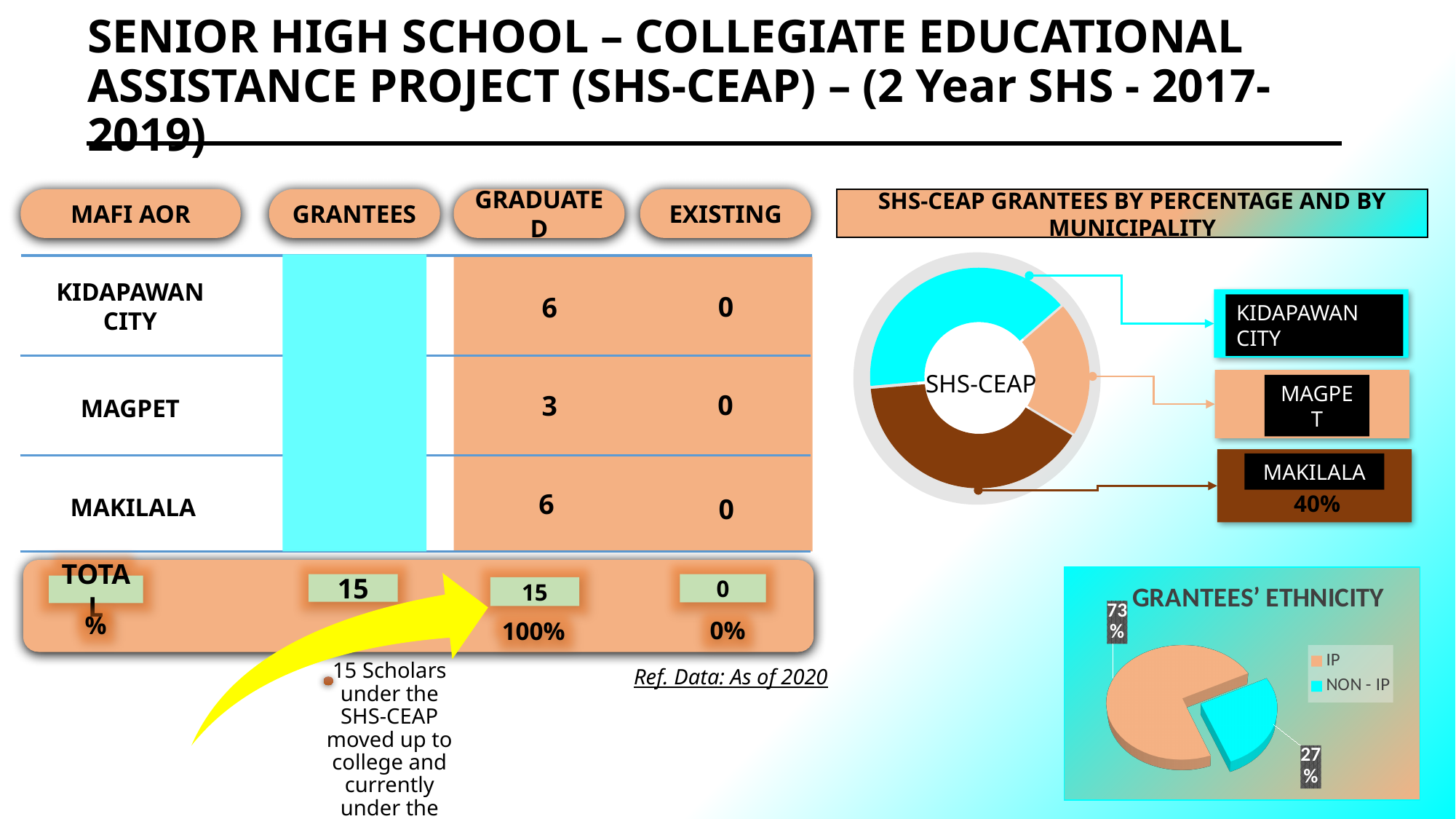
What kind of chart is the GRANTEES' ETHNICITY chart? Pie chart In the GRANTEES' ETHNICITY chart, which category has the larger share? IP In the SHS-CEAP GRANTEES BY PERCENTAGE AND BY MUNICIPALITY chart, which slice is larger, Makilala or Magpet? Makilala In the GRANTEES' ETHNICITY chart, what percentage of grantees are NON - IP? 27% In the SHS-CEAP GRANTEES BY PERCENTAGE AND BY MUNICIPALITY chart, which municipality has the smallest slice? Magpet In the GRANTEES' ETHNICITY chart, which category has the smaller share? NON - IP In the SHS-CEAP GRANTEES BY PERCENTAGE AND BY MUNICIPALITY chart, what colour is the Kidapawan City slice? Cyan In the GRANTEES' ETHNICITY chart, what is the difference in percentage points between IP and NON - IP? 46 How many municipalities are shown in the SHS-CEAP GRANTEES BY PERCENTAGE AND BY MUNICIPALITY chart? 3 In the SHS-CEAP GRANTEES BY PERCENTAGE AND BY MUNICIPALITY chart, what share of grantees is from Makilala? 40% How many entries does the legend of the GRANTEES' ETHNICITY chart list? 2 In the GRANTEES' ETHNICITY chart, what percentage of grantees are IP? 73%